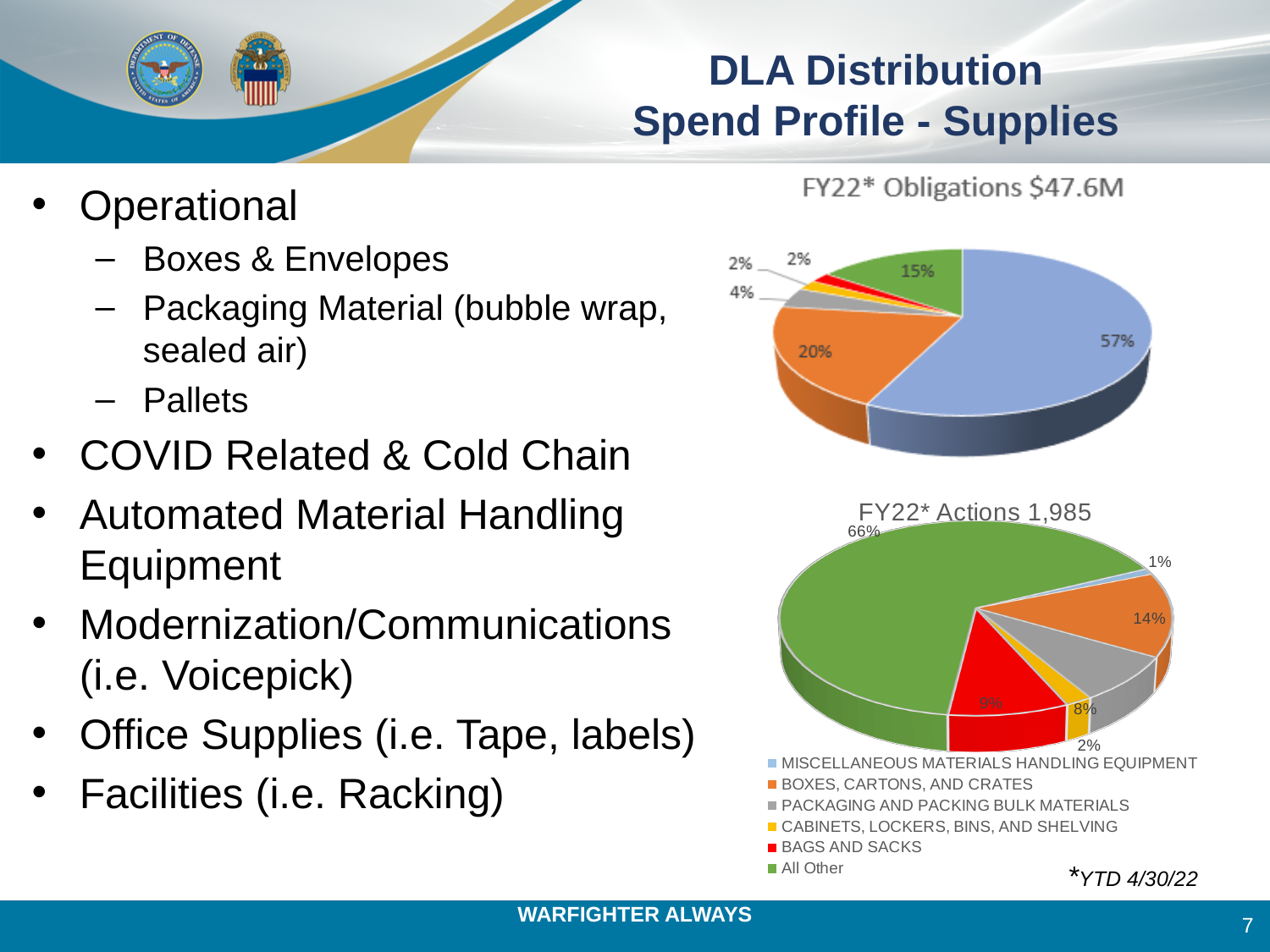
In the 'FY22* Obligations $47.6M' chart, what share is shown for the green slice (All Other)? 15% In the 'FY22* Obligations $47.6M' chart, what share is shown for the orange slice (Boxes, Cartons, and Crates)? 20% In the 'FY22* Obligations $47.6M' chart, what is the largest slice's share? 57% How many entries does the legend below the 'FY22* Actions 1,985' chart list? 6 In the 'FY22* Actions 1,985' chart, which is larger: the Bags and Sacks slice (red) or the Packaging and Packing Bulk Materials slice (gray)? Bags and Sacks What is the title of the top pie chart on the slide? FY22* Obligations $47.6M In the 'FY22* Obligations $47.6M' chart, what is the difference between the largest slice (57%) and the orange slice (20%)? 37% What kind of chart is the 'FY22* Obligations $47.6M' chart? Pie chart How many slices does the 'FY22* Actions 1,985' pie chart have? 6 In the 'FY22* Actions 1,985' chart, what share is shown for Miscellaneous Materials Handling Equipment (light blue slice)? 1% In the 'FY22* Actions 1,985' chart, what share is shown for All Other (green slice)? 66% In the 'FY22* Actions 1,985' chart, what share is shown for Boxes, Cartons, and Crates (orange slice)? 14%